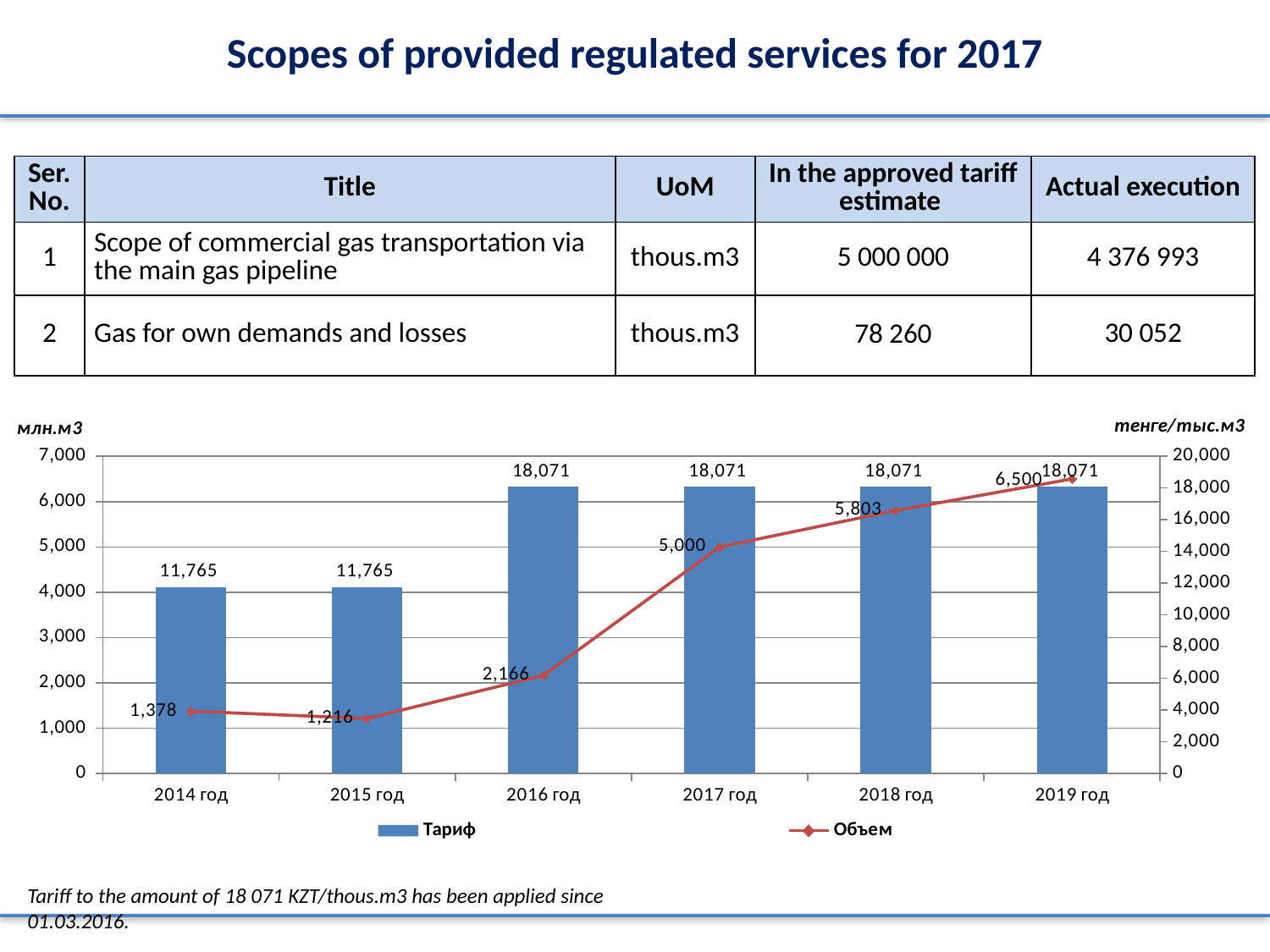
What is the value of the Тариф series for 2016 год? 18,071 In which year is the Объем series at its highest? 2019 год Does the Объем series rise or fall from 2015 год to 2019 год? rise What is the value of the Объем series for 2018 год? 5,803 In which year is the Объем series at its lowest? 2015 год What is the value of the Объем series for 2014 год? 1,378 What is the difference between the Тариф values for 2016 год and 2015 год? 6,306 What is the difference between the Объем values for 2019 год and 2018 год? 697 Which series in the chart is drawn as bars? Тариф How many series does the chart legend list? 2 Which is larger, the Объем value for 2016 год or for 2017 год? 2017 год How many years are shown on the x axis of the chart? 6